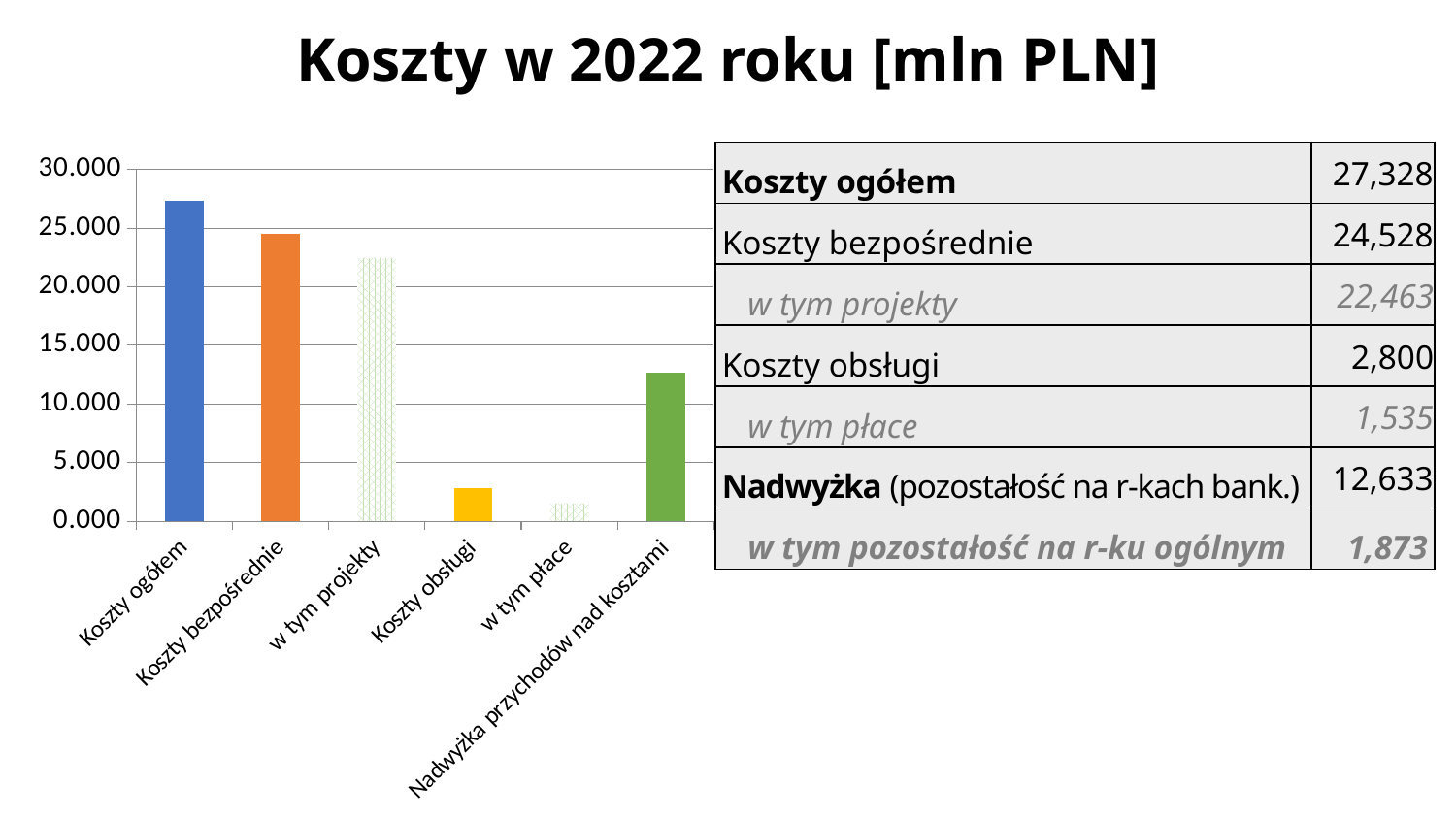
How many bars (categories) does the chart show? 6 What type of chart is shown on the slide? bar chart Which category has the lowest bar in the chart? w tym płace According to the table, what is the value for w tym płace? 1,535 According to the table, what is the value for Koszty bezpośrednie? 24,528 According to the table, what is the value for Koszty ogółem? 27,328 Is the value for Nadwyżka przychodów nad kosztami greater or less than 10.000 on the chart's axis? greater According to the table, what is the value for Koszty obsługi? 2,800 What is the title of the slide/chart? Koszty w 2022 roku [mln PLN] Is the value for Koszty obsługi greater or less than 5.000 on the chart's axis? less Which is larger, the bar for Koszty bezpośrednie or the bar for w tym projekty? Koszty bezpośrednie Which category has the highest bar in the chart? Koszty ogółem